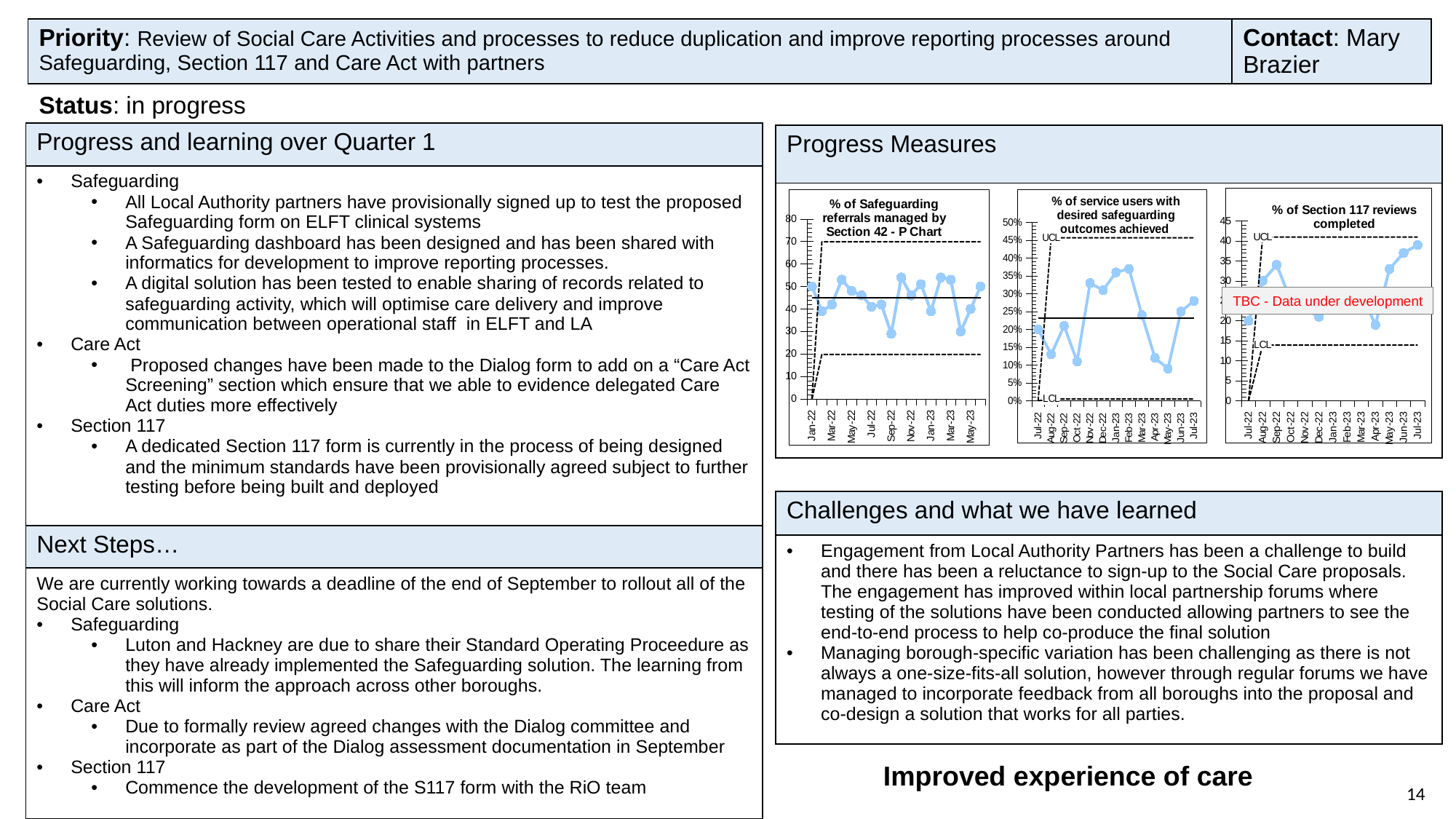
In the '% of Section 117 reviews completed' chart, is the LCL greater or less than 20? less In the '% of service users with desired safeguarding outcomes achieved' chart, is the LCL greater or less than 5%? less What kind of chart is the '% of Safeguarding referrals managed by Section 42 - P Chart'? Line chart In the '% of Section 117 reviews completed' chart, is the UCL greater or less than 35? greater In the '% of Section 117 reviews completed' chart, do the plotted values overall rise or fall from Jul-22 to Jul-23? rise What note is overlaid in red on the '% of Section 117 reviews completed' chart? TBC - Data under development What is the first month shown on the x axis of the '% of Safeguarding referrals managed by Section 42 - P Chart'? Jan-22 How many charts are shown in the Progress Measures section of the slide? 3